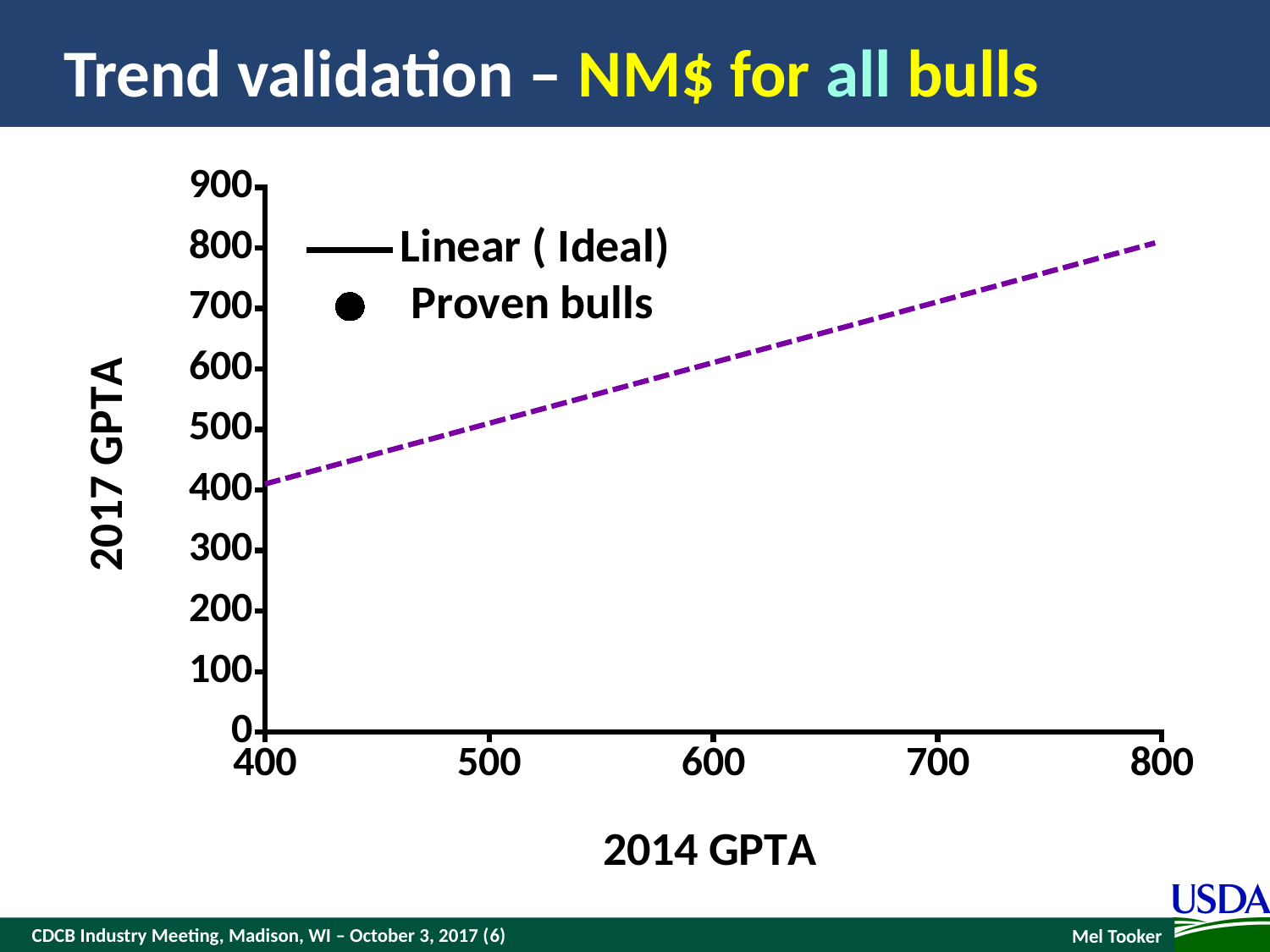
Is the value of the Linear (Ideal) line at a 2014 GPTA of 800 greater or less than 700? greater Is the value of the Linear (Ideal) line at a 2014 GPTA of 700 greater or less than 600? greater How many series does the legend list? 2 What are the two entries listed in the legend? Linear ( Ideal) and Proven bulls What kind of chart is shown on the slide? line chart How many labelled tick marks are on the x axis? 5 Is the value of the Linear (Ideal) line at a 2014 GPTA of 600 greater or less than 500? greater Does the dashed Linear (Ideal) line rise or fall as 2014 GPTA increases? rises What is the label of the x axis? 2014 GPTA